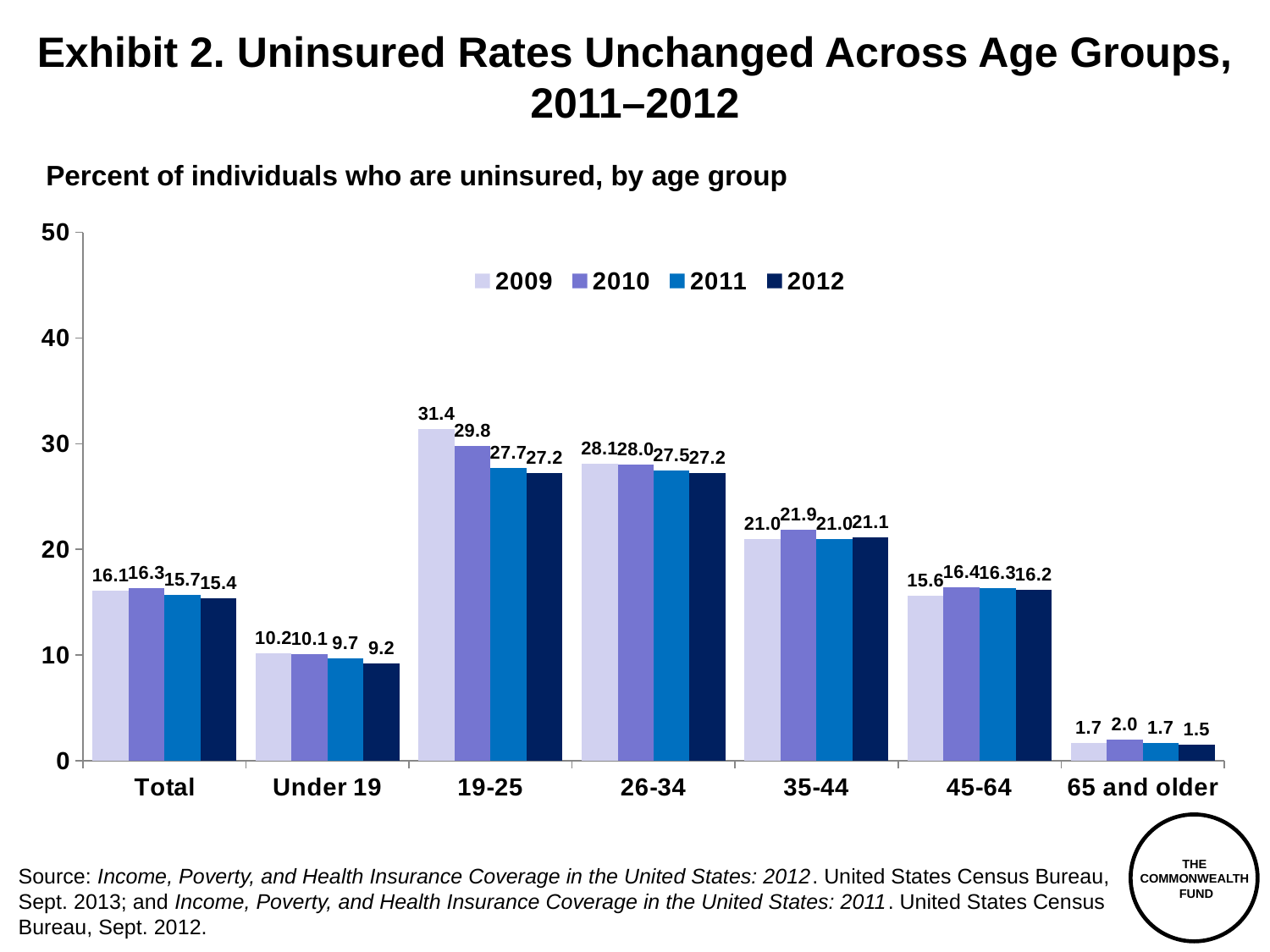
Which was higher in 2010: the uninsured rate for 35-44 or for 45-64? 35-44 What was the uninsured rate for the 65 and older group in 2010? 2.0 Did the uninsured rate for the 19-25 age group rise or fall from 2009 to 2012? fall How many series does the legend list? 4 Which age group had the highest uninsured rate in 2012? 19-25 and 26-34 (tied at 27.2) What kind of chart is shown on the slide? bar chart Which age group had the lowest uninsured rate in 2011? 65 and older What was the uninsured rate for the 19-25 age group in 2009? 31.4 How many age-group categories are shown on the x axis? 7 What is the difference between the 2009 and 2012 uninsured rates for the Under 19 group? 1.0 What was the uninsured rate for the Total category in 2012? 15.4 What is the difference between the 2009 and 2012 uninsured rates for the 19-25 age group? 4.2